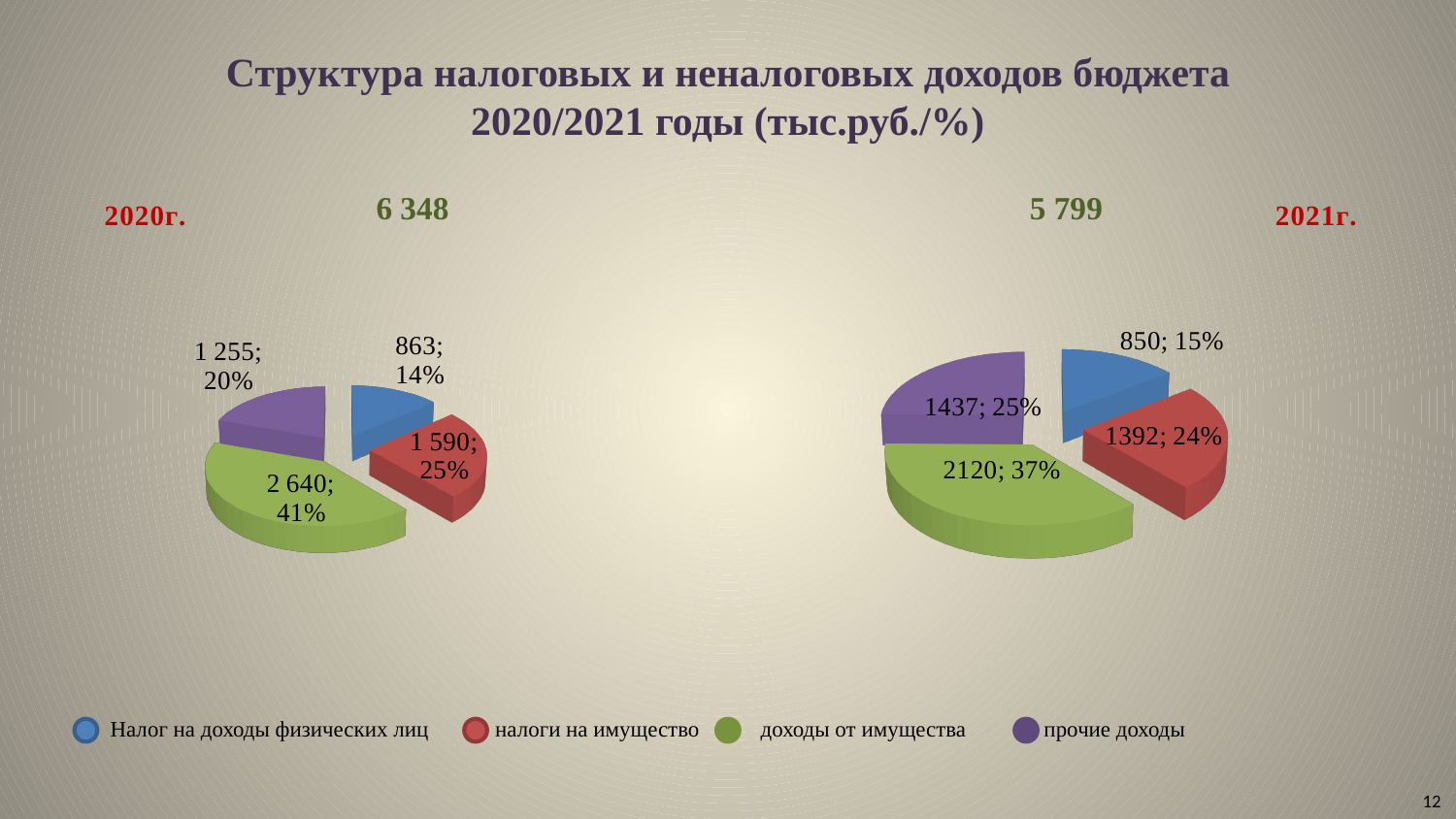
In the 2020г. pie chart (left), which category has the largest slice? доходы от имущества In the 2021г. pie chart (right), what share does прочие доходы have? 25% In the 2021г. pie chart (right), which category has the smallest slice? Налог на доходы физических лиц Which is larger: прочие доходы in 2020г. or прочие доходы in 2021г.? прочие доходы in 2021г. What total is shown above the 2020г. pie chart (left)? 6 348 How many categories does each pie chart contain? 4 In the 2020г. pie chart (left), what is the difference between доходы от имущества and налоги на имущество in тыс.руб.? 1 050 Which colour represents Налог на доходы физических лиц in the legend? Blue In the 2021г. pie chart (right), what is the value for налоги на имущество? 1392; 24% How many entries does the legend list? 4 In the 2020г. pie chart (left), what is the value for доходы от имущества? 2 640; 41% What type of chart is used on this slide for the 2020 and 2021 data? Pie chart